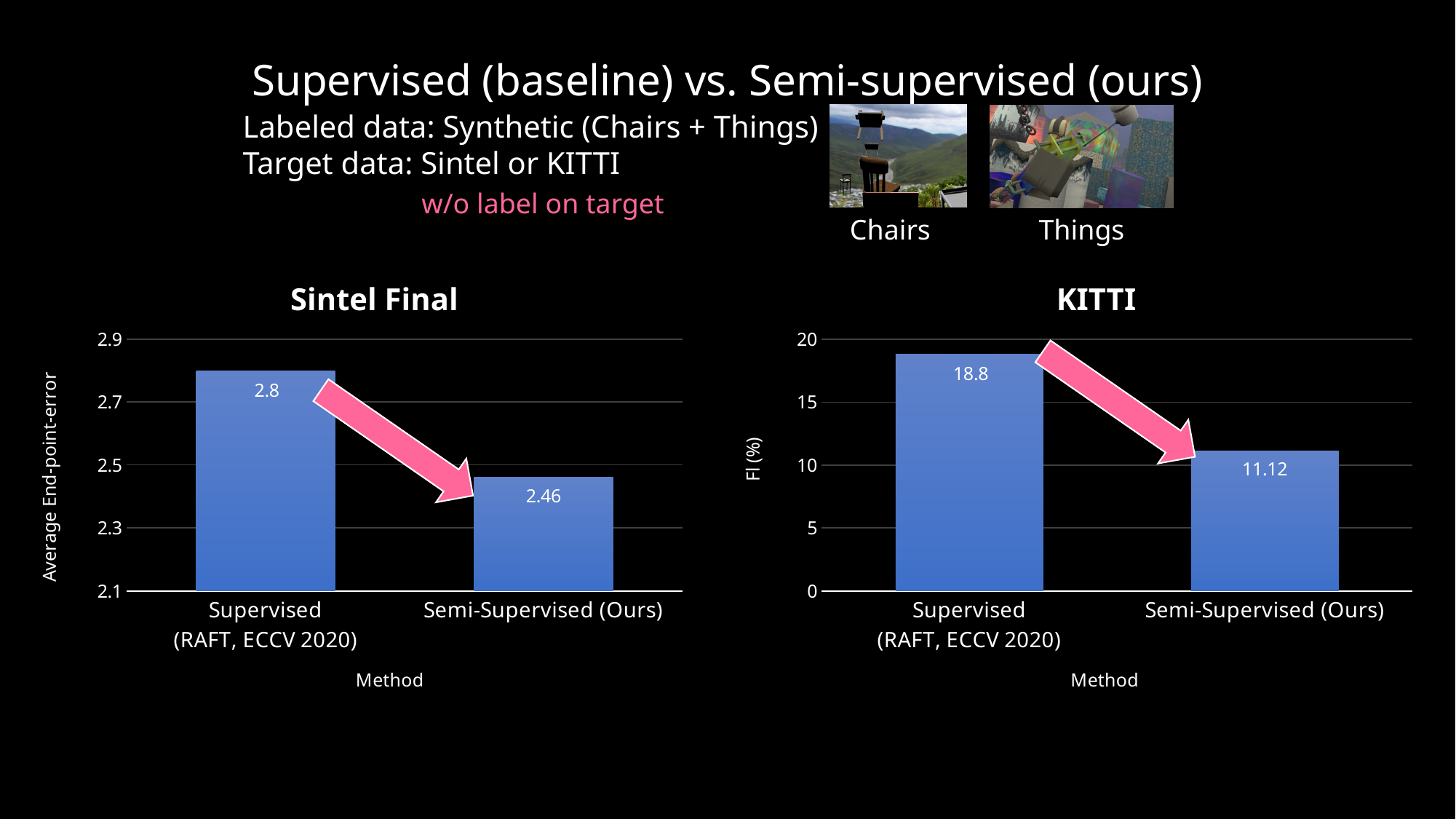
In the Sintel Final chart, which method has the highest Average End-point-error? Supervised (RAFT, ECCV 2020) What type of chart is the KITTI chart? bar chart What is the y-axis label of the KITTI chart? Fl (%) In the KITTI chart, what is the difference in Fl (%) between Supervised (RAFT, ECCV 2020) and Semi-Supervised (Ours)? 7.68 In the Sintel Final chart, what is the Average End-point-error for Supervised (RAFT, ECCV 2020)? 2.8 In the KITTI chart, what is the Fl (%) value for Supervised (RAFT, ECCV 2020)? 18.8 In the KITTI chart, which method has the lowest Fl (%)? Semi-Supervised (Ours) In the KITTI chart, what is the Fl (%) value for Semi-Supervised (Ours)? 11.12 In the KITTI chart, is the value for Semi-Supervised (Ours) greater or less than 15? less In the Sintel Final chart, what is the difference in Average End-point-error between Supervised (RAFT, ECCV 2020) and Semi-Supervised (Ours)? 0.34 How many bars are shown in the Sintel Final chart? 2 In the Sintel Final chart, what is the Average End-point-error for Semi-Supervised (Ours)? 2.46